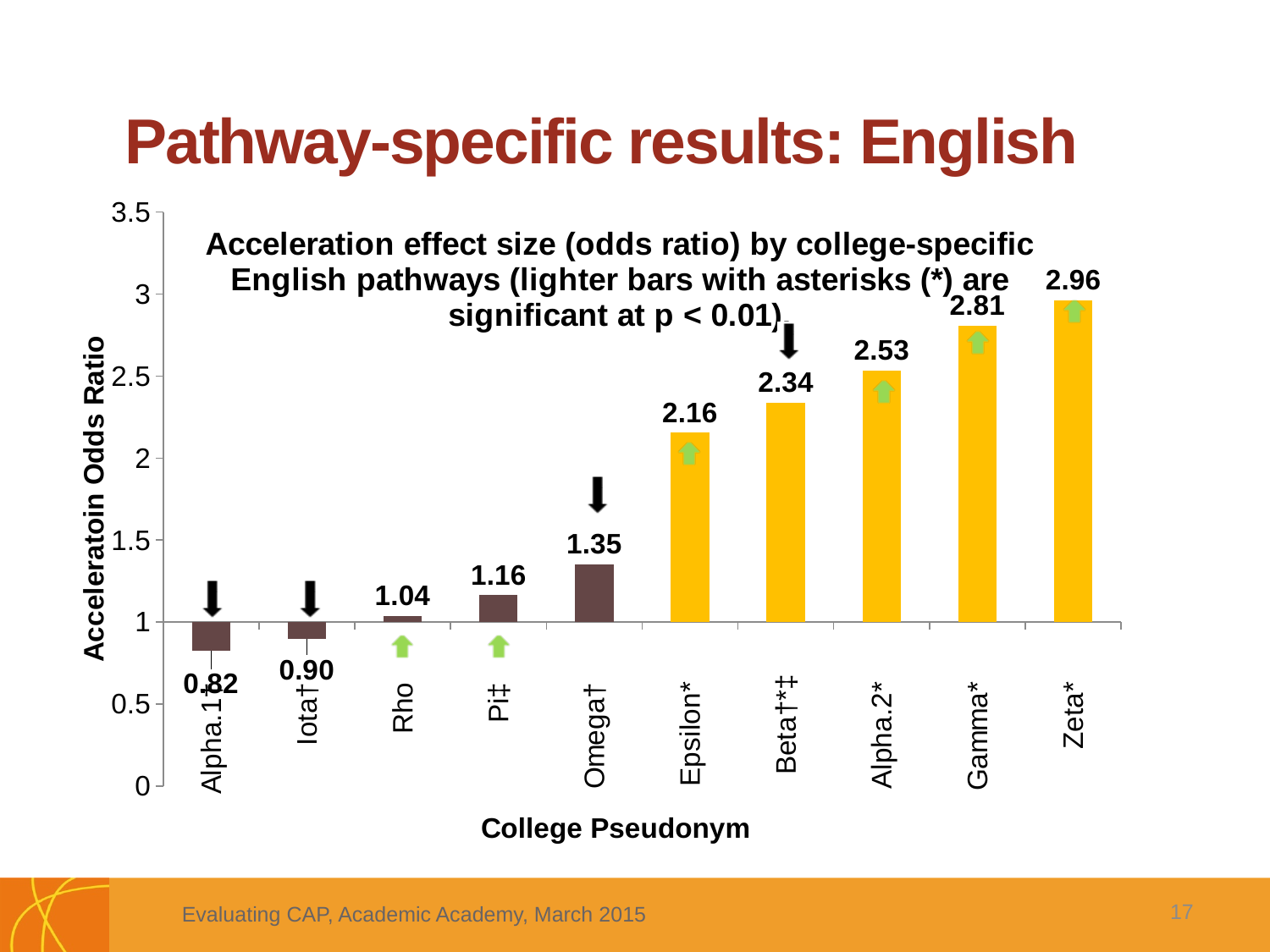
Is the value for Alpha.2* greater or less than 2.5? greater Which has a larger acceleration odds ratio, Beta†*‡ or Pi‡? Beta†*‡ How many college pseudonyms are shown on the x axis? 10 What kind of chart is shown on the slide? bar chart Which college pseudonym has the highest acceleration odds ratio? Zeta* What is the difference between the acceleration odds ratios for Gamma* and Epsilon*? 0.65 Which college pseudonym has the lowest acceleration odds ratio? Alpha.1† Do the acceleration odds ratios rise or fall from left to right along the x axis? rise What is the acceleration odds ratio for Zeta*? 2.96 What is the acceleration odds ratio for Rho? 1.04 What is the label of the y axis? Acceleratoin Odds Ratio What is the acceleration odds ratio for Omega†? 1.35